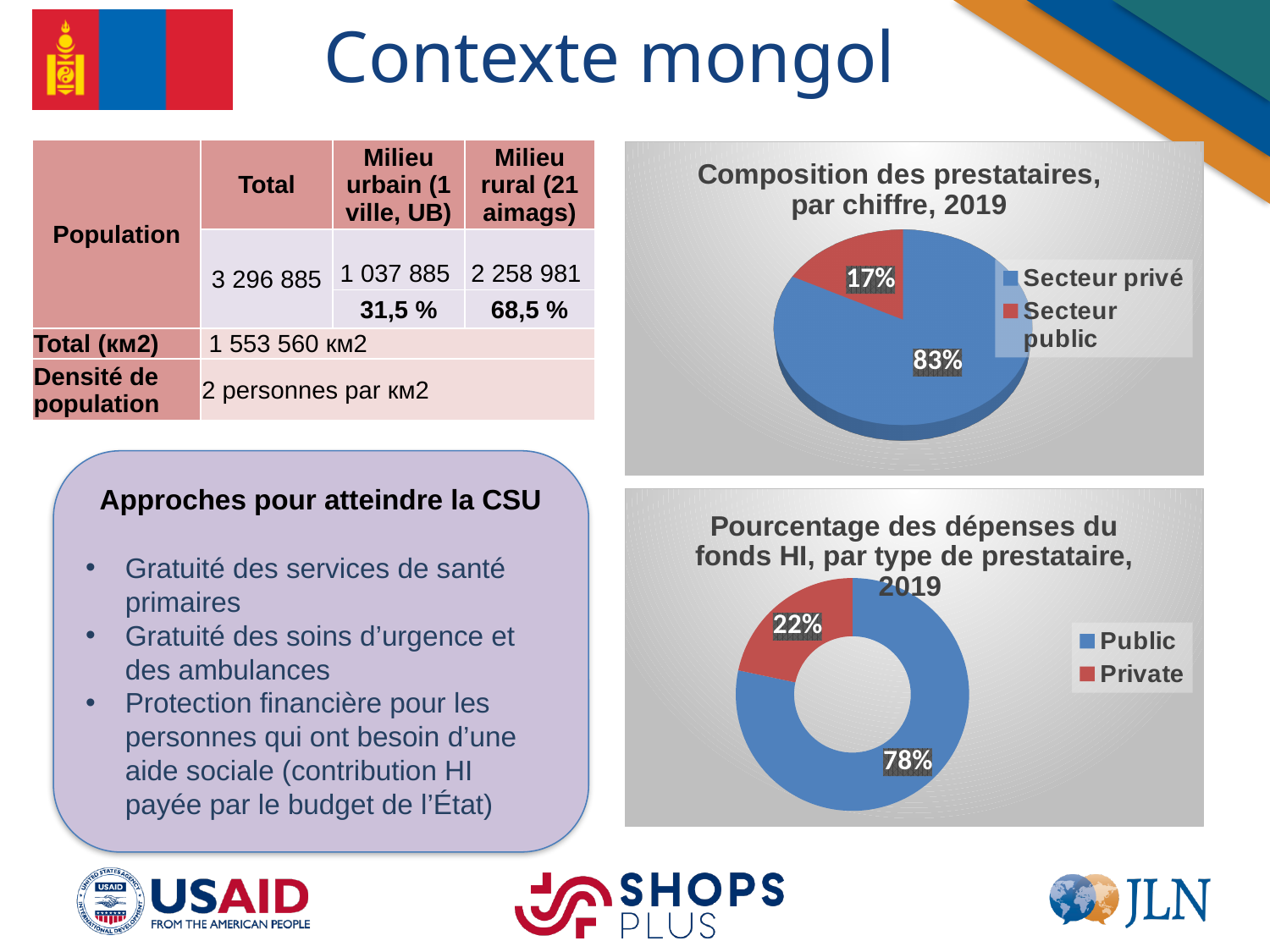
In the chart 'Pourcentage des dépenses du fonds HI, par type de prestataire, 2019', which category has the smaller share? Private In the chart 'Composition des prestataires, par chiffre, 2019', what is the difference in percentage points between the two slices? 66 In the chart 'Composition des prestataires, par chiffre, 2019', what share is labelled for the blue slice (Secteur privé)? 83% In the chart 'Composition des prestataires, par chiffre, 2019', which sector has the larger slice? Secteur privé In the chart 'Composition des prestataires, par chiffre, 2019', what share is labelled for the red slice (Secteur public)? 17% What kind of chart is 'Composition des prestataires, par chiffre, 2019'? Pie chart In the chart 'Pourcentage des dépenses du fonds HI, par type de prestataire, 2019', what is the difference in percentage points between Public and Private? 56 In the chart 'Pourcentage des dépenses du fonds HI, par type de prestataire, 2019', what colour represents Public? Blue In the chart 'Pourcentage des dépenses du fonds HI, par type de prestataire, 2019', what share is labelled for Private? 22% What kind of chart is 'Pourcentage des dépenses du fonds HI, par type de prestataire, 2019'? Doughnut chart In the chart 'Pourcentage des dépenses du fonds HI, par type de prestataire, 2019', what share is labelled for Public? 78% How many entries does the legend of 'Composition des prestataires, par chiffre, 2019' list? 2